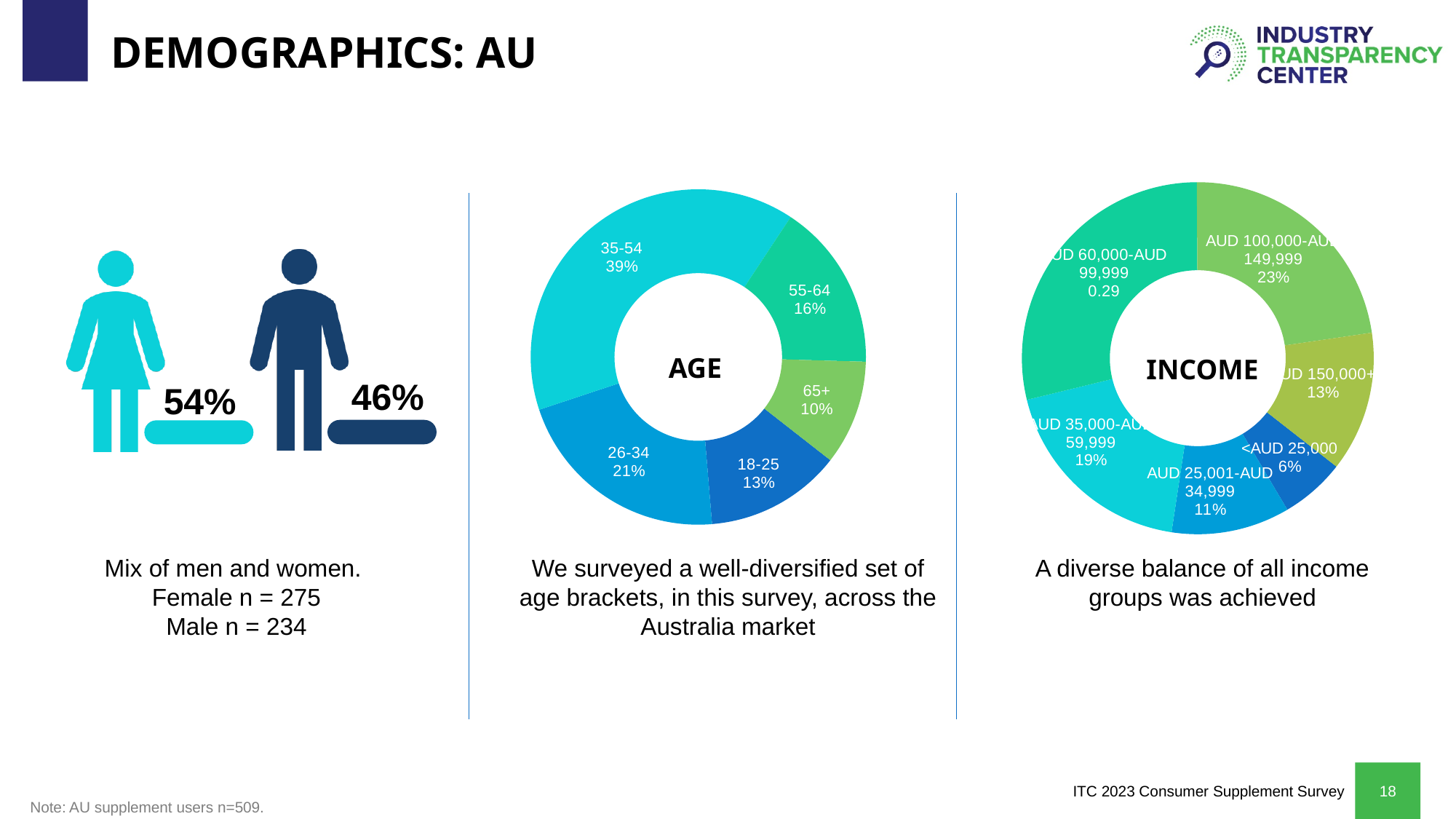
In the AGE chart, what is the difference in percentage points between the 26-34 and 55-64 brackets? 5 percentage points In the INCOME chart, which income group has the smallest share? <AUD 25,000 What type of chart is the AGE chart? Pie chart (donut) In the AGE chart, what percentage of respondents are aged 35-54? 39% In the AGE chart, which age bracket has the largest share? 35-54 In the INCOME chart, what percentage of respondents earn AUD 25,001-AUD 34,999? 11% How many age brackets are shown in the AGE chart? 5 In the INCOME chart, what percentage of respondents earn AUD 100,000-AUD 149,999? 23% In the AGE chart, which has a larger share: 55-64 or 18-25? 55-64 In the AGE chart, what percentage of respondents are aged 18-25? 13% In the AGE chart, which age bracket has the smallest share? 65+ In the INCOME chart, what percentage of respondents earn less than AUD 25,000? 6%